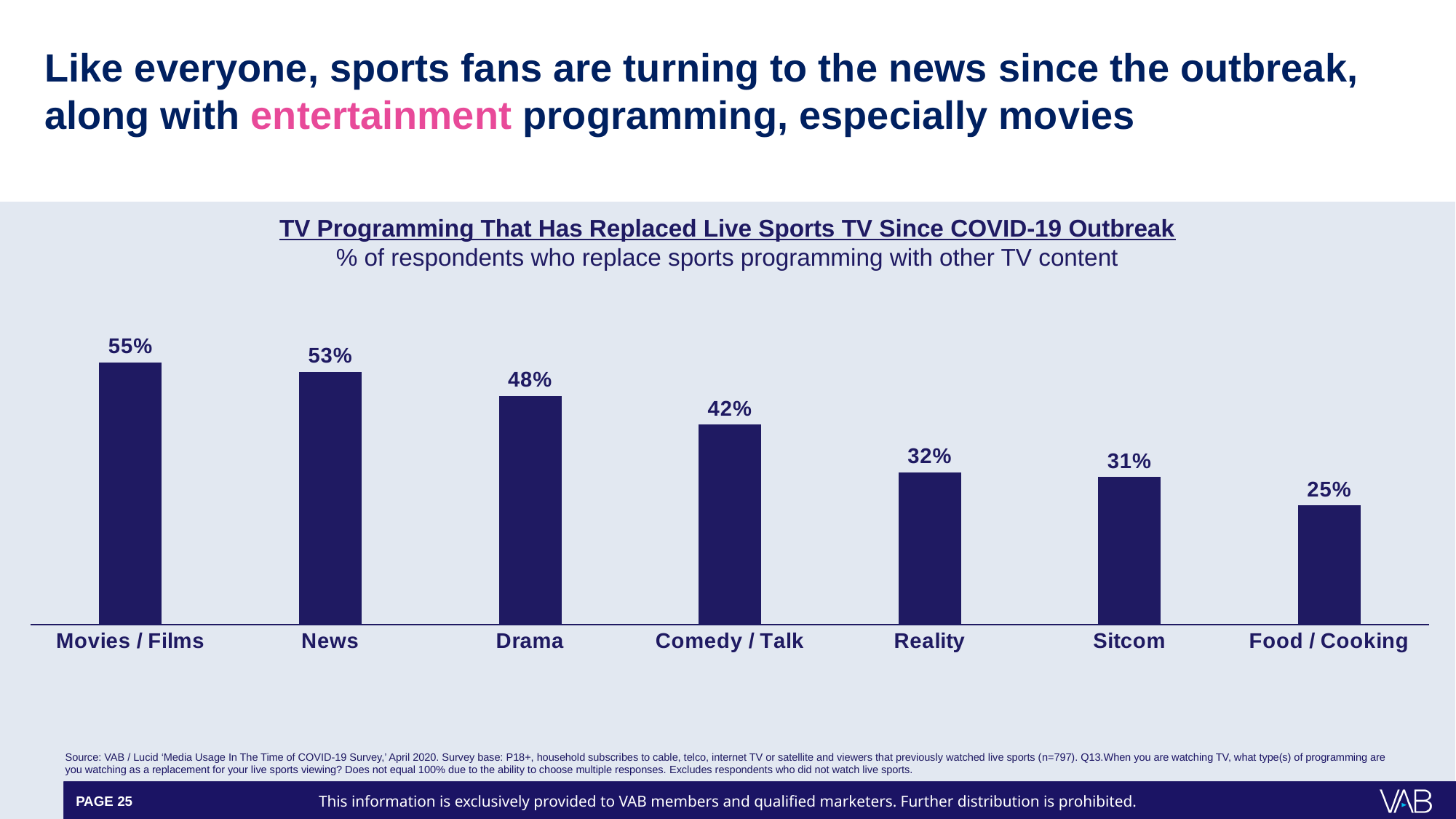
Which has a higher value, Comedy / Talk or Sitcom? Comedy / Talk Which programming category has the highest percentage? Movies / Films What is the difference in percentage points between Drama and Reality? 16 What is the value shown for News? 53% How many programming categories are shown in the chart? 7 What percentage of respondents replaced live sports with Movies / Films? 55% What is the value for Food / Cooking? 25% Which programming category has the lowest percentage? Food / Cooking What is the difference in percentage points between Movies / Films and News? 2 What kind of chart is shown on the slide? Bar chart Do the values rise or fall from left to right across the categories? Fall What percentage is shown for Comedy / Talk? 42%